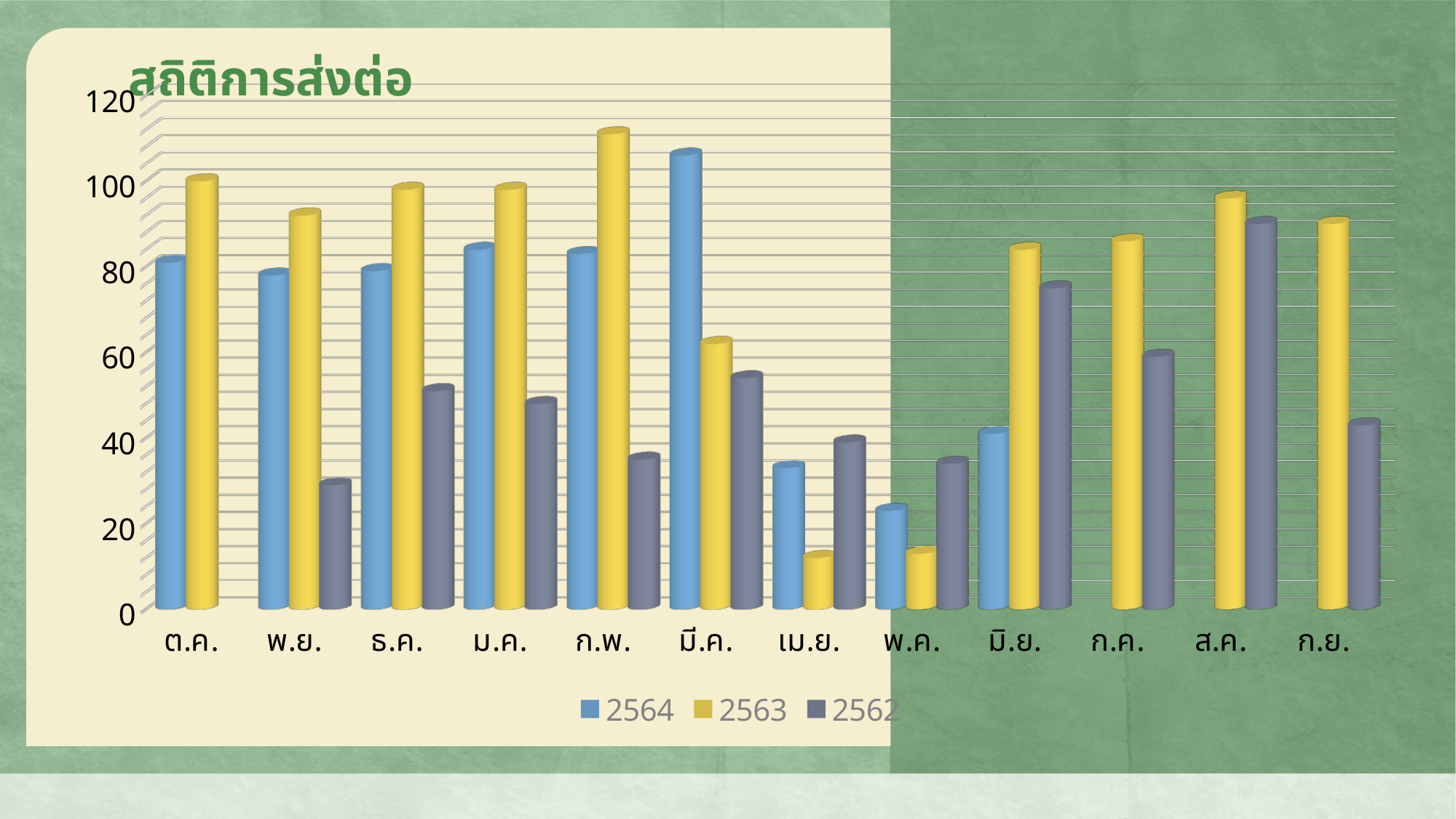
Which series is shown in yellow? 2563 What kind of chart is shown on the slide? bar chart How many month categories are shown on the x axis? 12 In which month is the 2564 series lowest? พ.ค. In มี.ค., which series has the larger value, 2564 or 2563? 2564 Is the value for 2563 in เม.ย. greater or less than 20? less In which month is the 2562 series highest? ส.ค. In which month is the 2563 series highest? ก.พ. How many series does the legend list? 3 In which month is the 2564 series highest? มี.ค. What is the title of the chart? สถิติการส่งต่อ Is the value for 2563 in ก.พ. greater or less than 100? greater